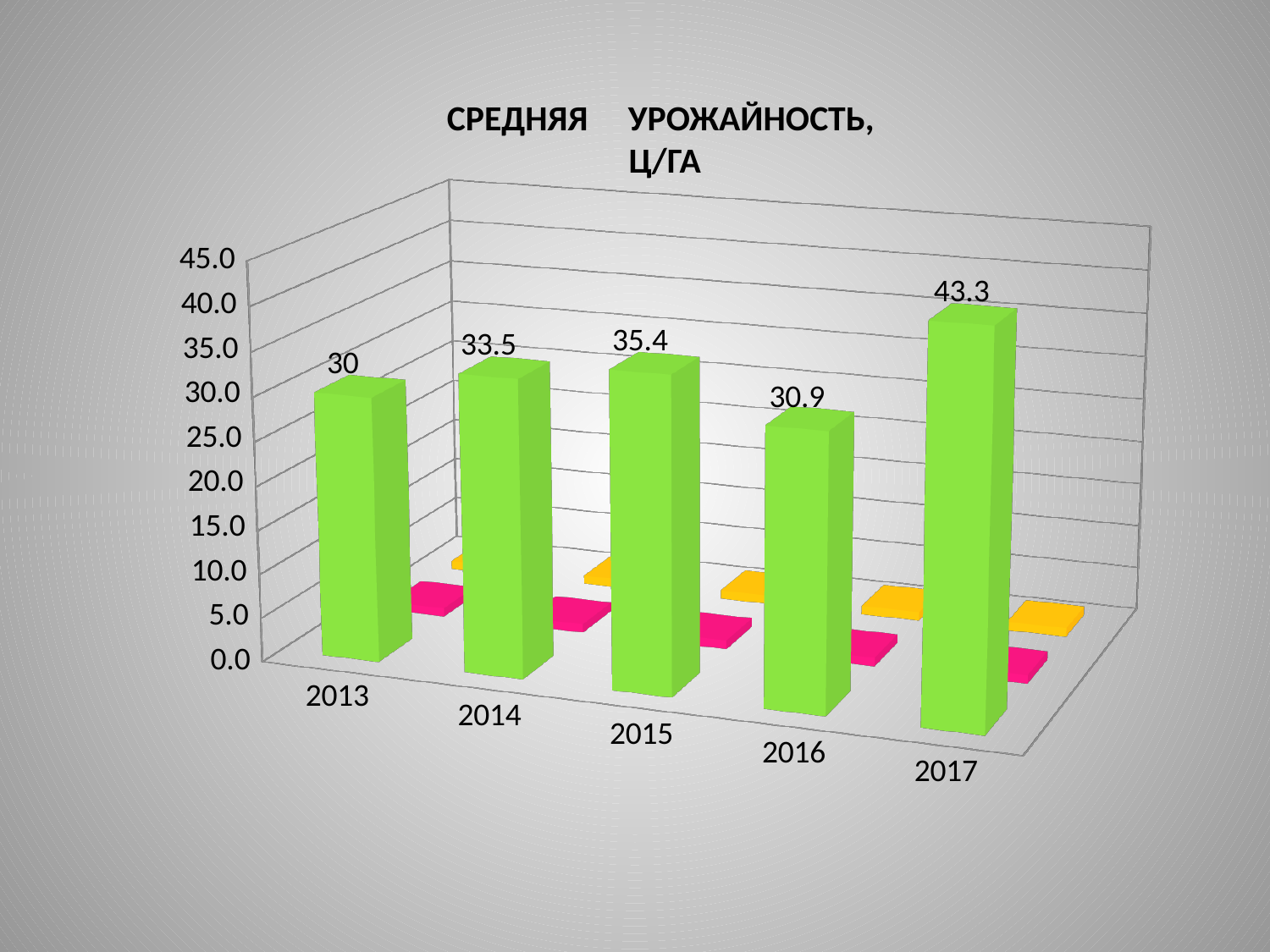
What is the value of the green bar for 2013? 30 What is the value of the green bar for 2016? 30.9 Which year has the lowest green bar? 2013 How many years are shown on the x axis? 5 What is the value of the green bar for 2015? 35.4 What is the value of the green bar for 2014? 33.5 Which year has the highest green bar? 2017 What kind of chart is shown on the slide? Bar chart What is the value of the green bar for 2017? 43.3 What is the difference between the green bar values for 2017 and 2013? 13.3 What is the title of the chart? СРЕДНЯЯ УРОЖАЙНОСТЬ, Ц/ГА Which year has the larger green bar value, 2015 or 2016? 2015